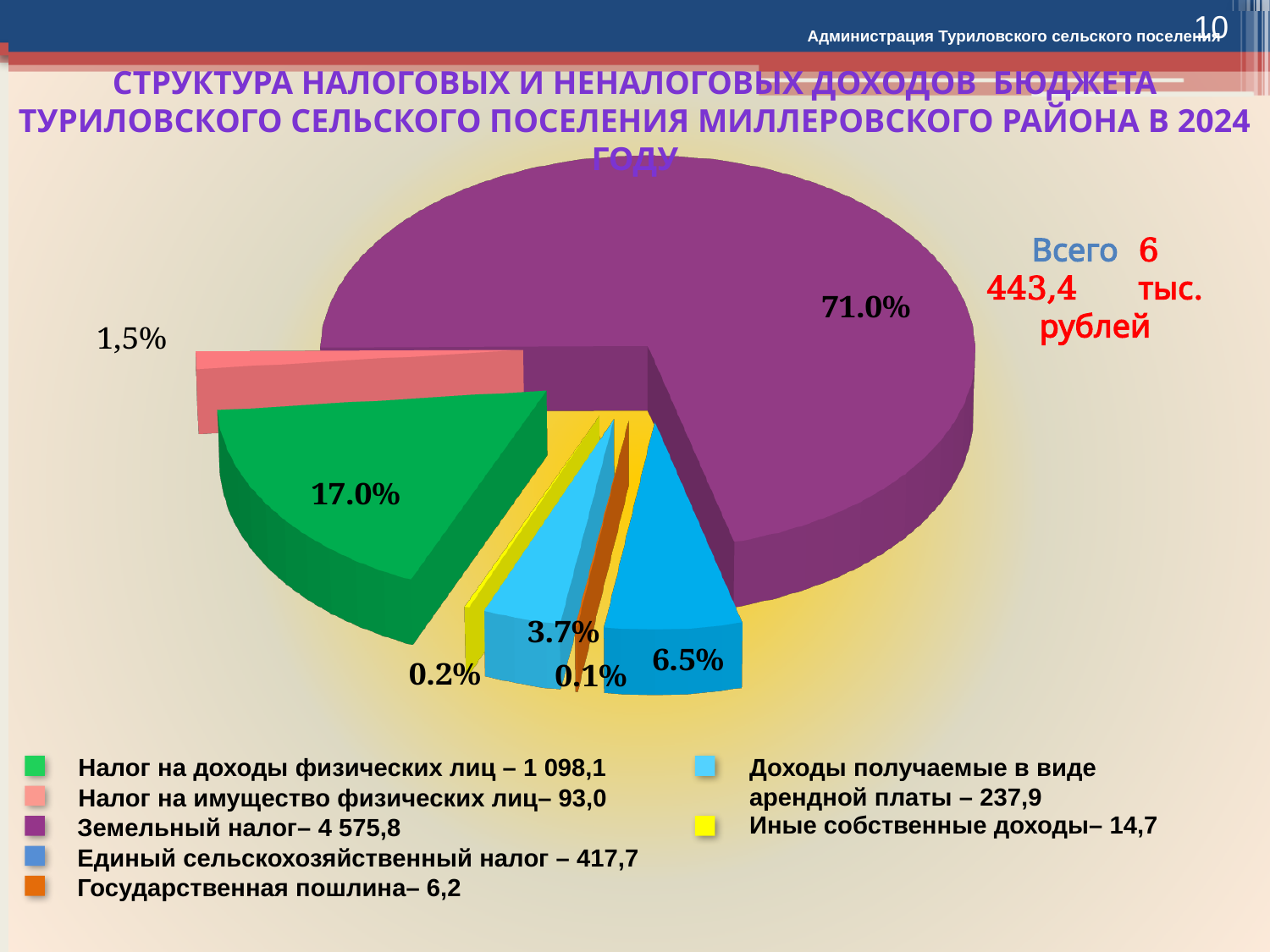
What percentage share is shown for Единый сельскохозяйственный налог? 6.5% Which category has the smallest share of the pie? Государственная пошлина How many slices does the pie chart have? 7 What percentage share is shown for Налог на доходы физических лиц? 17.0% What kind of chart is shown on the slide? pie chart What percentage share is shown for Доходы получаемые в виде арендной платы? 3.7% What total amount (Всего) is stated on the slide? 6 443,4 тыс. рублей What percentage share is shown for Земельный налог? 71.0% What amount is listed in the legend for Земельный налог? 4 575,8 Which category has the largest share of the pie? Земельный налог Which has the larger share: Налог на имущество физических лиц or Доходы получаемые в виде арендной платы? Доходы получаемые в виде арендной платы What is the difference in percentage points between the share of Земельный налог and the share of Налог на доходы физических лиц? 54.0